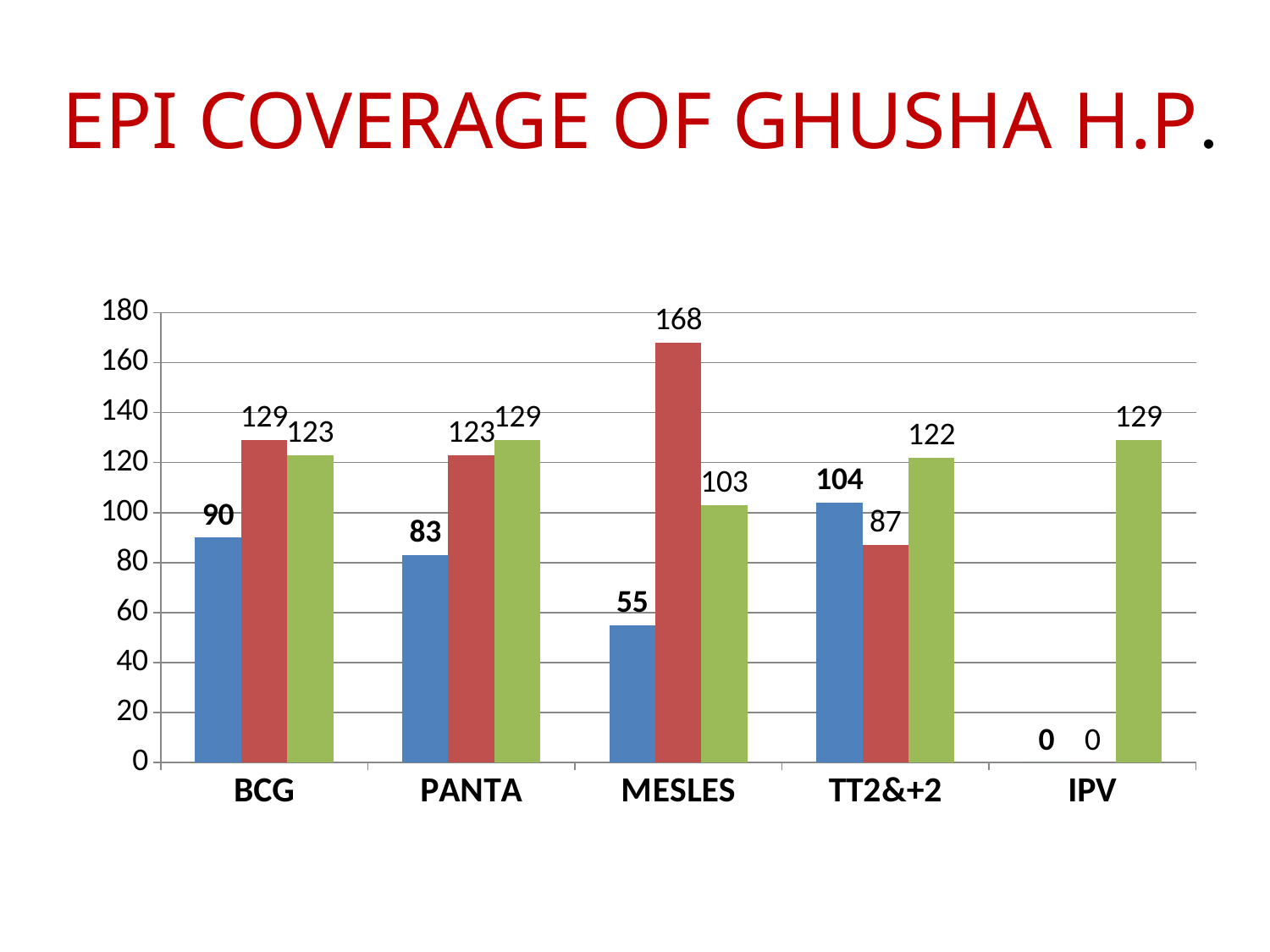
What is the value of the green bar for IPV? 129 What is the value of the red bar for MESLES? 168 What is the difference between the red bar and the blue bar for MESLES? 113 What is the value of the blue bar for TT2&+2? 104 What kind of chart is shown on the slide? bar chart Which is larger for TT2&+2, the blue bar or the red bar? the blue bar Which category has the lowest blue bar? IPV What is the value of the blue bar for PANTA? 83 How many categories are shown on the x axis? 5 Which category has the highest red bar? MESLES What is the title of the slide? EPI COVERAGE OF GHUSHA H.P. What is the difference between the green bar for BCG and the green bar for MESLES? 20